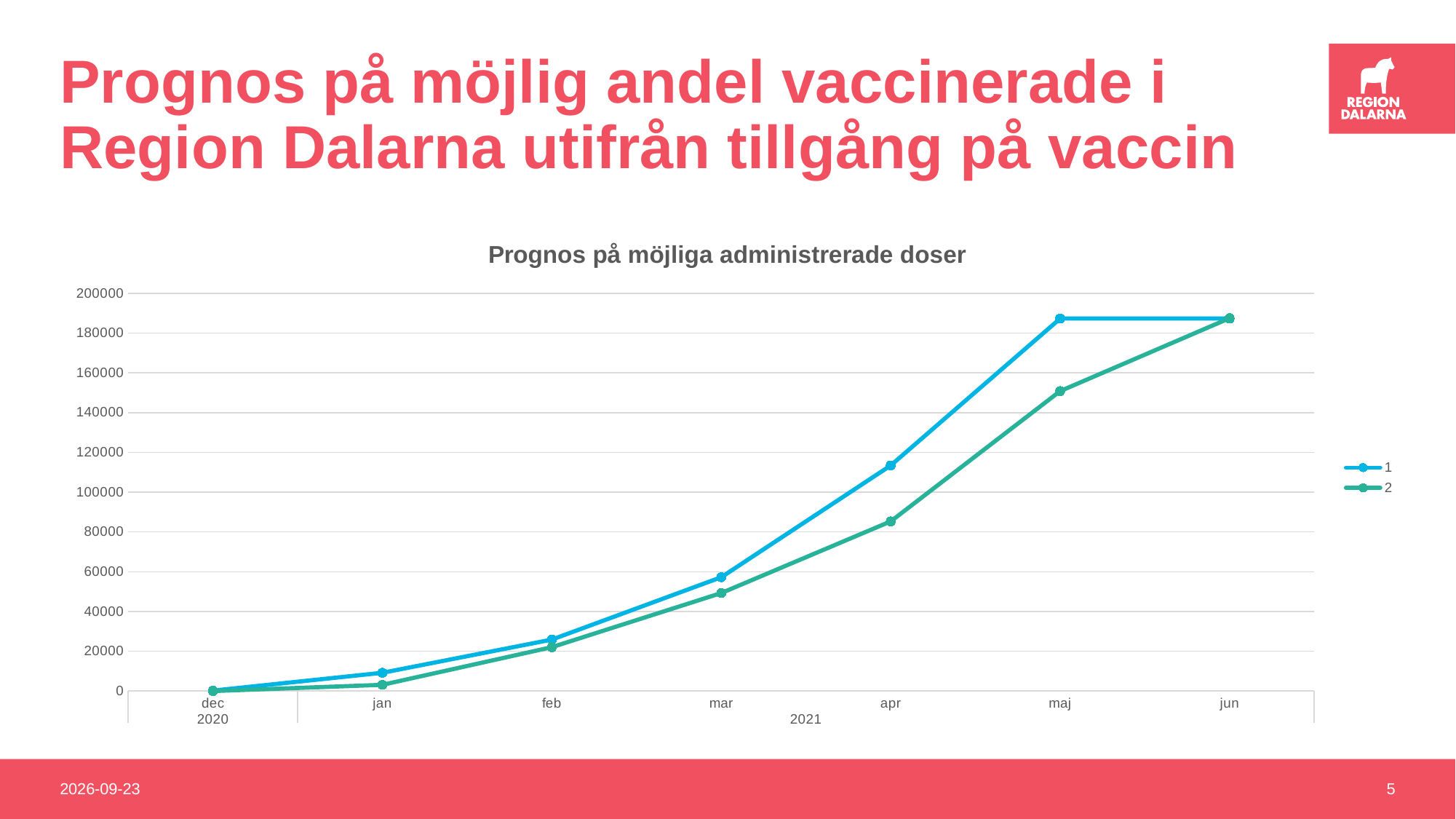
Is the value for series 1 in maj greater or less than 180000? greater Is the value for series 2 in jan greater or less than 20000? less Is the value for series 2 in apr greater or less than 100000? less Which series has the larger value in apr, series 1 or series 2? series 1 How many months are plotted along the x axis? 7 What kind of chart is shown on the slide? line chart Which series has the larger value in maj, series 1 or series 2? series 1 How many series does the legend list? 2 Do the values of series 1 rise or fall from dec to maj? rise What is the title of the chart? Prognos på möjliga administrerade doser